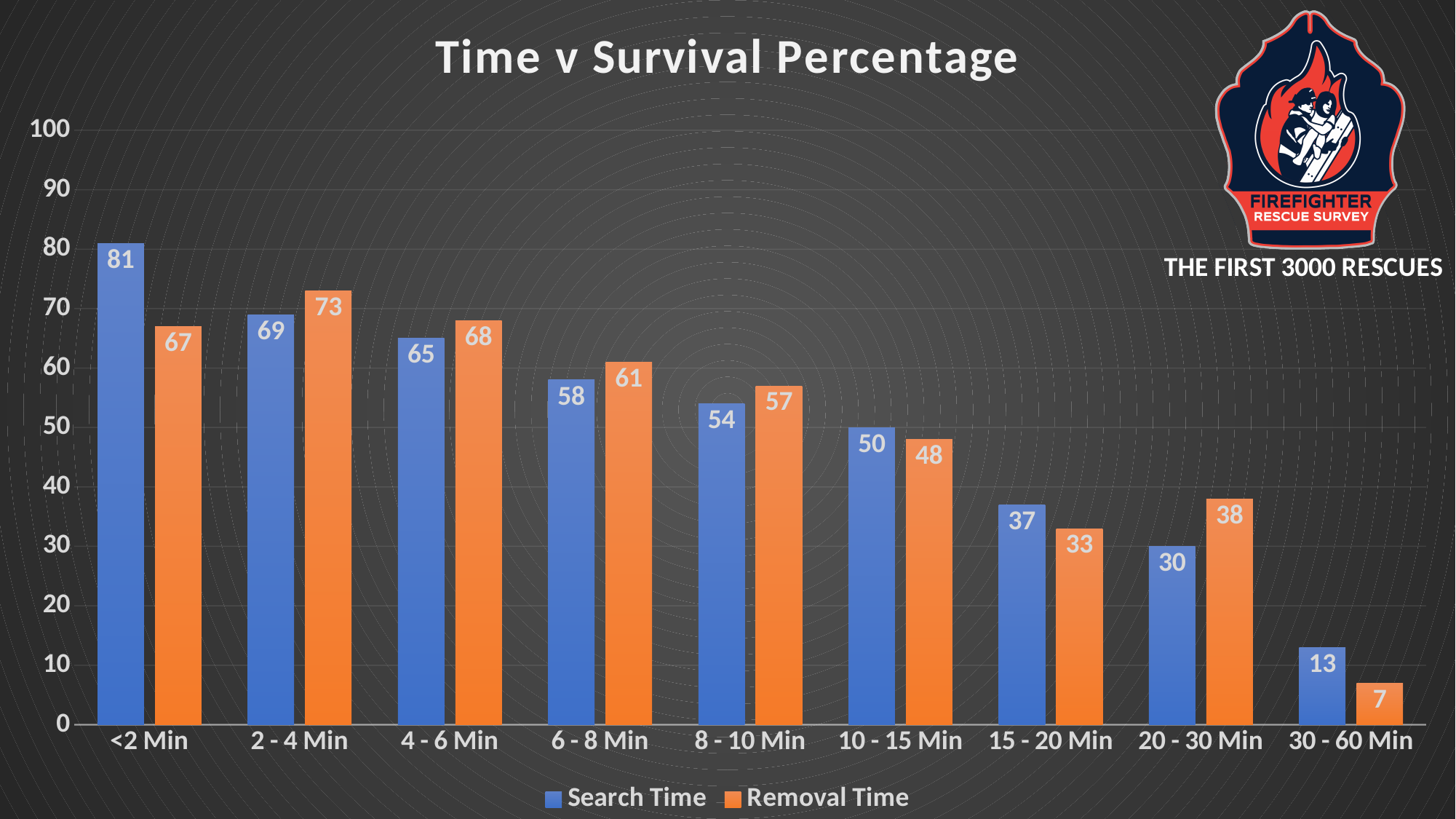
For the 20 - 30 Min category, which is larger: Search Time or Removal Time? Removal Time What is the Search Time survival percentage for the <2 Min category? 81 How many series does the legend list? 2 How many time categories are shown on the x axis? 9 What kind of chart is shown on the slide? Bar chart What is the title of the chart? Time v Survival Percentage What is the difference between the Search Time and Removal Time values for the <2 Min category? 14 What is the Removal Time value for the 2 - 4 Min category? 73 Which category has the lowest Removal Time value? 30 - 60 Min Which category has the highest Search Time value? <2 Min What is the Search Time value for the 30 - 60 Min category? 13 Do the Search Time values generally rise or fall as time increases along the x axis? Fall